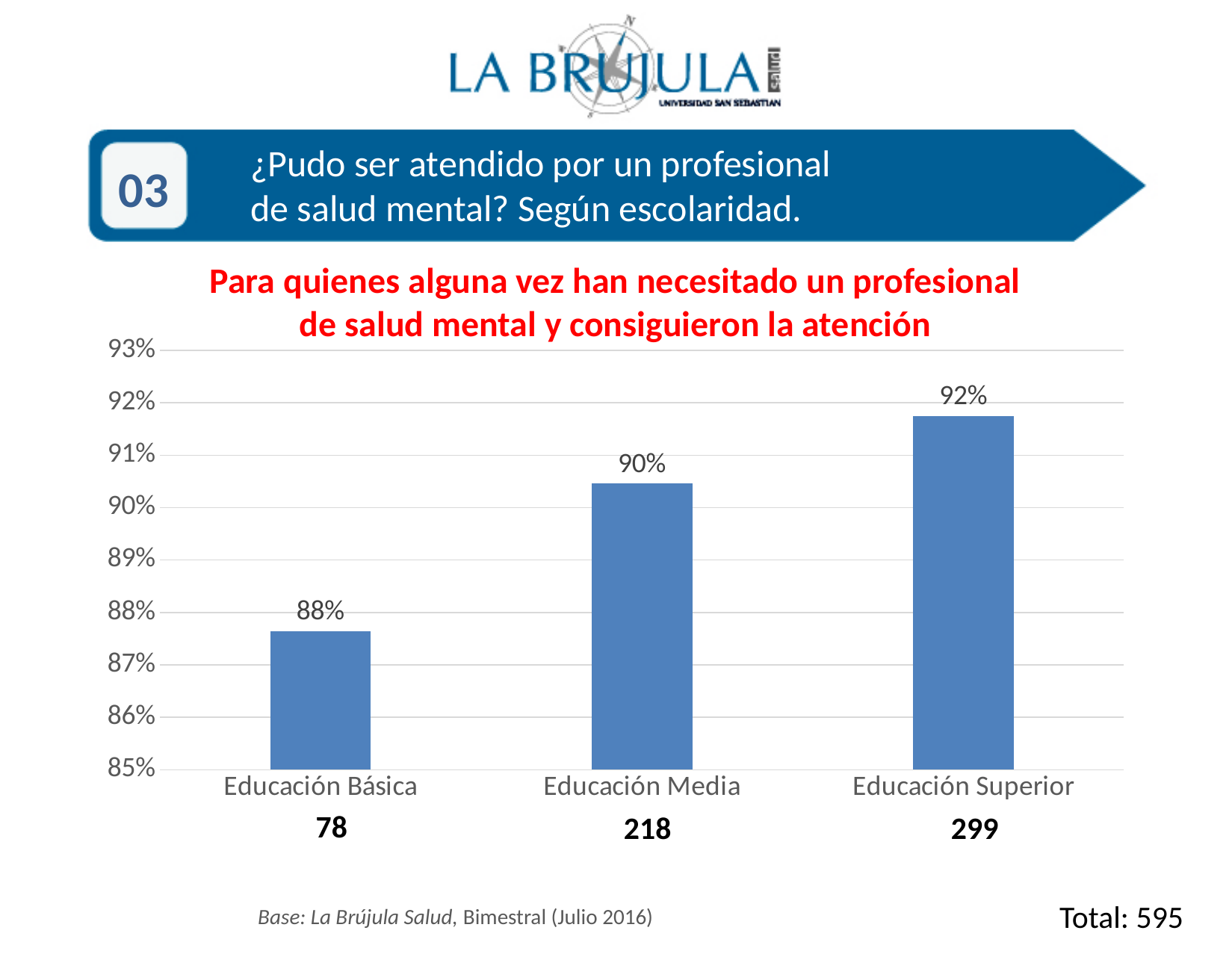
What kind of chart is shown on the slide? bar chart What is the value for Educación Media? 90% What is the value for Educación Básica? 88% What is the difference between the values for Educación Superior and Educación Básica? 4% Is the value for Educación Superior greater or less than 91%? greater What is the value for Educación Superior? 92% How many categories are shown on the x axis? 3 What is the total shown at the bottom right of the slide? 595 Which category has the lowest value? Educación Básica Do the values rise or fall from Educación Básica to Educación Superior? rise Which is larger, the value for Educación Media or the value for Educación Básica? Educación Media Which category has the highest value? Educación Superior